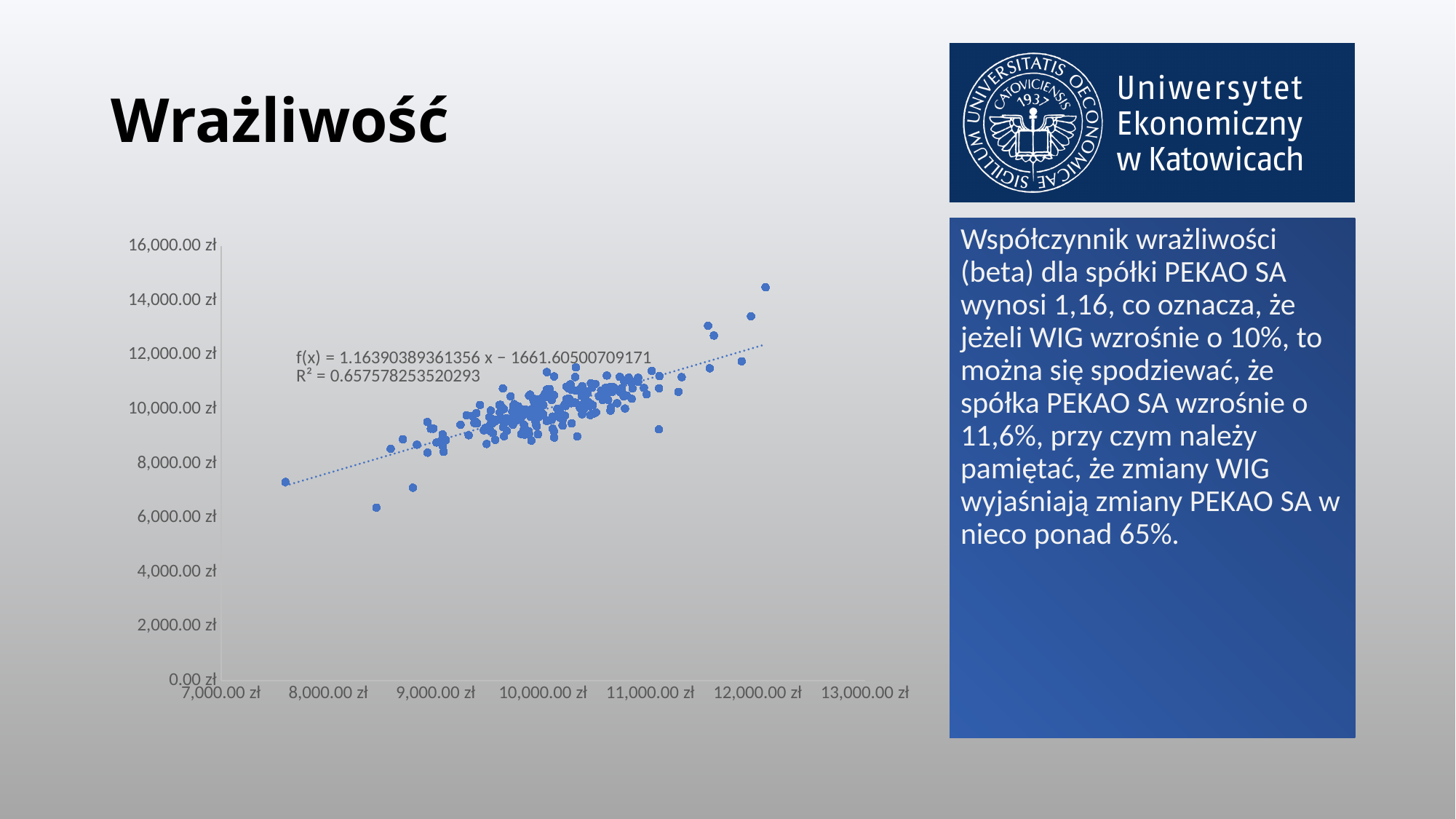
Is the highest plotted point on the chart greater or less than 14,000.00 zł on the y-axis? greater Is the lowest plotted point on the chart greater or less than 8,000.00 zł on the y-axis? less Do the plotted values generally rise or fall as the x-axis values increase? Rise What R² value is printed on the chart? 0.657578253520293 What is the maximum value shown on the x-axis of the chart? 13,000.00 zł Is the x-axis value of the leftmost plotted point greater or less than 8,000.00 zł? less What is the slope coefficient shown in the trendline equation f(x) on the chart? 1.16390389361356 What kind of chart is shown on the slide? Scatter chart What is the maximum value shown on the y-axis of the chart? 16,000.00 zł What is the minimum value shown on the x-axis of the chart? 7,000.00 zł